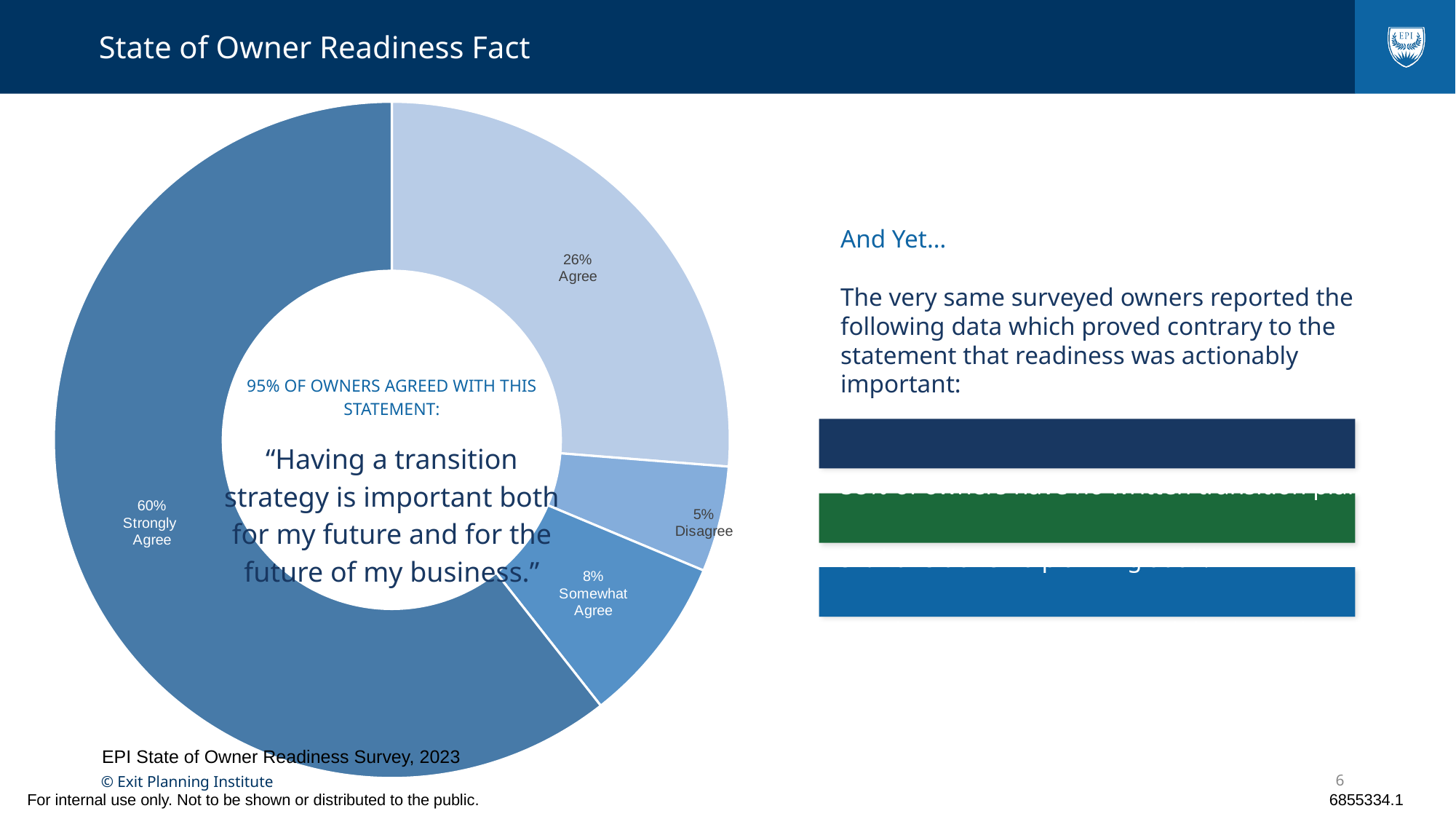
Which response category has the smallest share of the donut chart? Disagree What is the source cited below the chart? EPI State of Owner Readiness Survey, 2023 Which response category has the largest share of the donut chart? Strongly Agree What kind of chart is shown on the left of the slide? Donut chart What percentage of owners responded "Strongly Agree" in the donut chart? 60% What percentage of owners responded "Somewhat Agree"? 8% What is the difference in percentage points between "Strongly Agree" and "Agree"? 34 How many response categories are shown in the donut chart? 4 What percentage of owners responded "Disagree"? 5% Which is larger, the share for "Somewhat Agree" or the share for "Disagree"? Somewhat Agree According to the text in the centre of the chart, what percentage of owners agreed with the statement? 95% What percentage of owners responded "Agree" in the donut chart? 26%